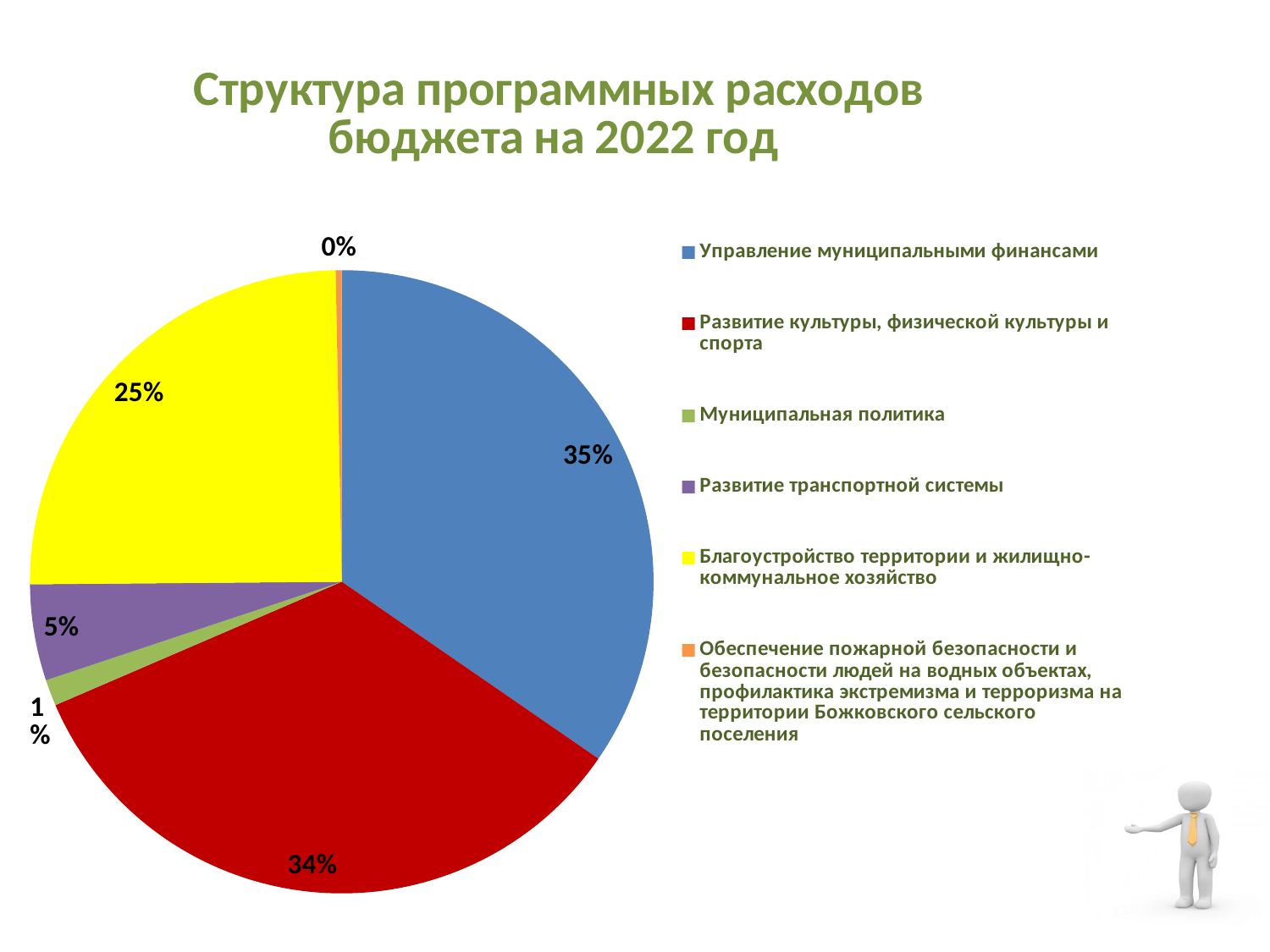
Which has a larger share: "Развитие транспортной системы" or "Муниципальная политика"? Развитие транспортной системы What is the title of the chart on the slide? Структура программных расходов бюджета на 2022 год What share of the pie does "Управление муниципальными финансами" have? 35% What share of the pie does "Развитие культуры, физической культуры и спорта" have? 34% What type of chart is shown on the slide? pie chart What share of the pie does "Муниципальная политика" have? 1% How many categories does the legend list? 6 Which category has the largest share of the pie? Управление муниципальными финансами Which category has the smallest share of the pie? Обеспечение пожарной безопасности и безопасности людей на водных объектах, профилактика экстремизма и терроризма на территории Божковского сельского поселения What is the difference in percentage points between the shares of "Управление муниципальными финансами" and "Благоустройство территории и жилищно-коммунальное хозяйство"? 10%